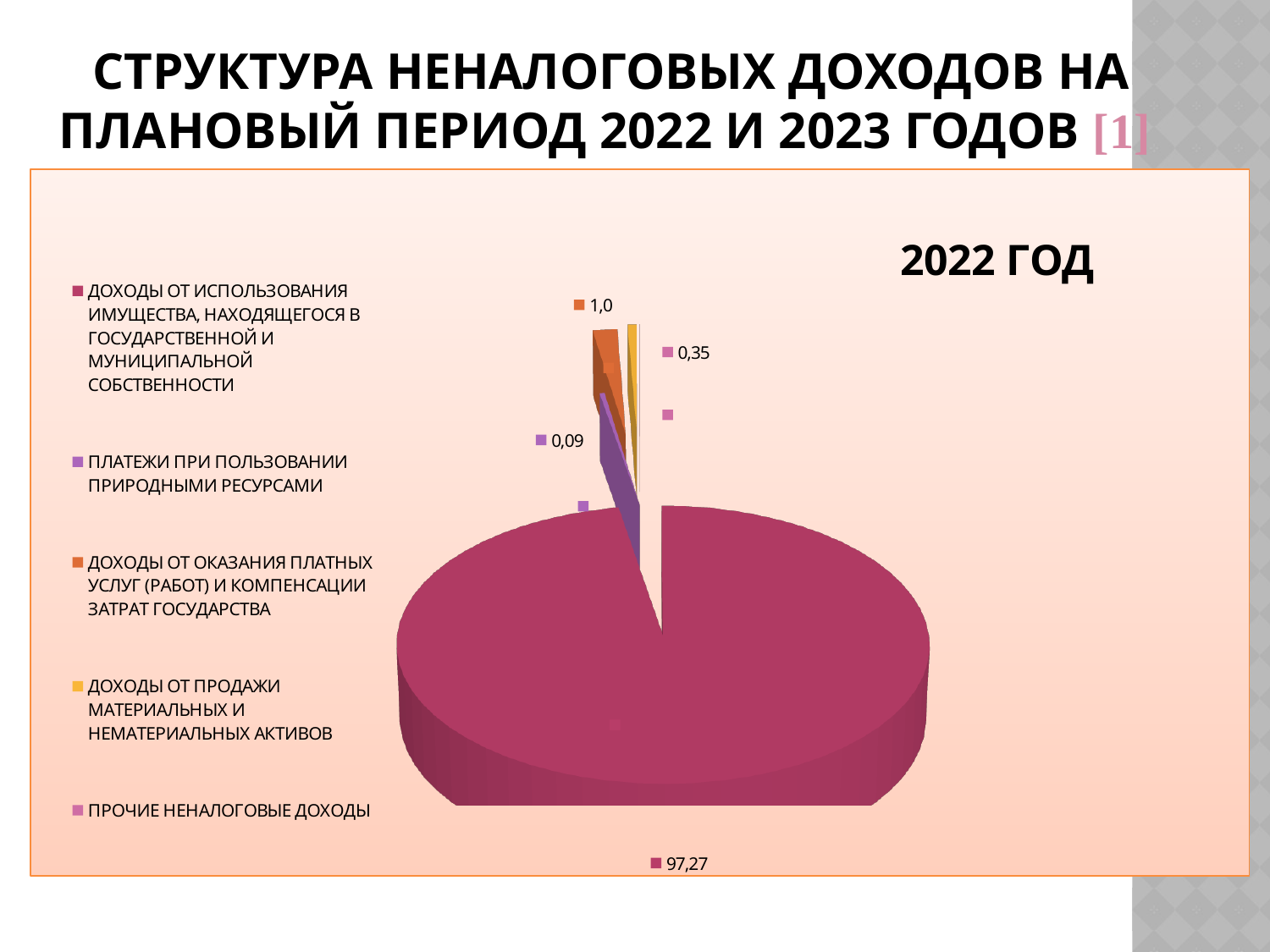
How many categories does the chart legend list? 5 Which is larger: the slice for ДОХОДЫ ОТ ИСПОЛЬЗОВАНИЯ ИМУЩЕСТВА or the slice for ДОХОДЫ ОТ ОКАЗАНИЯ ПЛАТНЫХ УСЛУГ? ДОХОДЫ ОТ ИСПОЛЬЗОВАНИЯ ИМУЩЕСТВА What is the smallest value labelled on the chart? 0,09 What colour is the largest slice of the pie? dark pink What is the title shown on the chart? 2022 ГОД What value is shown for ДОХОДЫ ОТ ОКАЗАНИЯ ПЛАТНЫХ УСЛУГ (РАБОТ) И КОМПЕНСАЦИИ ЗАТРАТ ГОСУДАРСТВА? 1,0 What is the value of the largest slice of the pie? 97,27 What kind of chart is shown on the slide? pie chart What is the difference between the largest slice (97,27) and the slice labelled 1,0? 96,27 Which category has the largest share of the pie? ДОХОДЫ ОТ ИСПОЛЬЗОВАНИЯ ИМУЩЕСТВА, НАХОДЯЩЕГОСЯ В ГОСУДАРСТВЕННОЙ И МУНИЦИПАЛЬНОЙ СОБСТВЕННОСТИ Is the value for ДОХОДЫ ОТ ИСПОЛЬЗОВАНИЯ ИМУЩЕСТВА greater or less than 90? greater